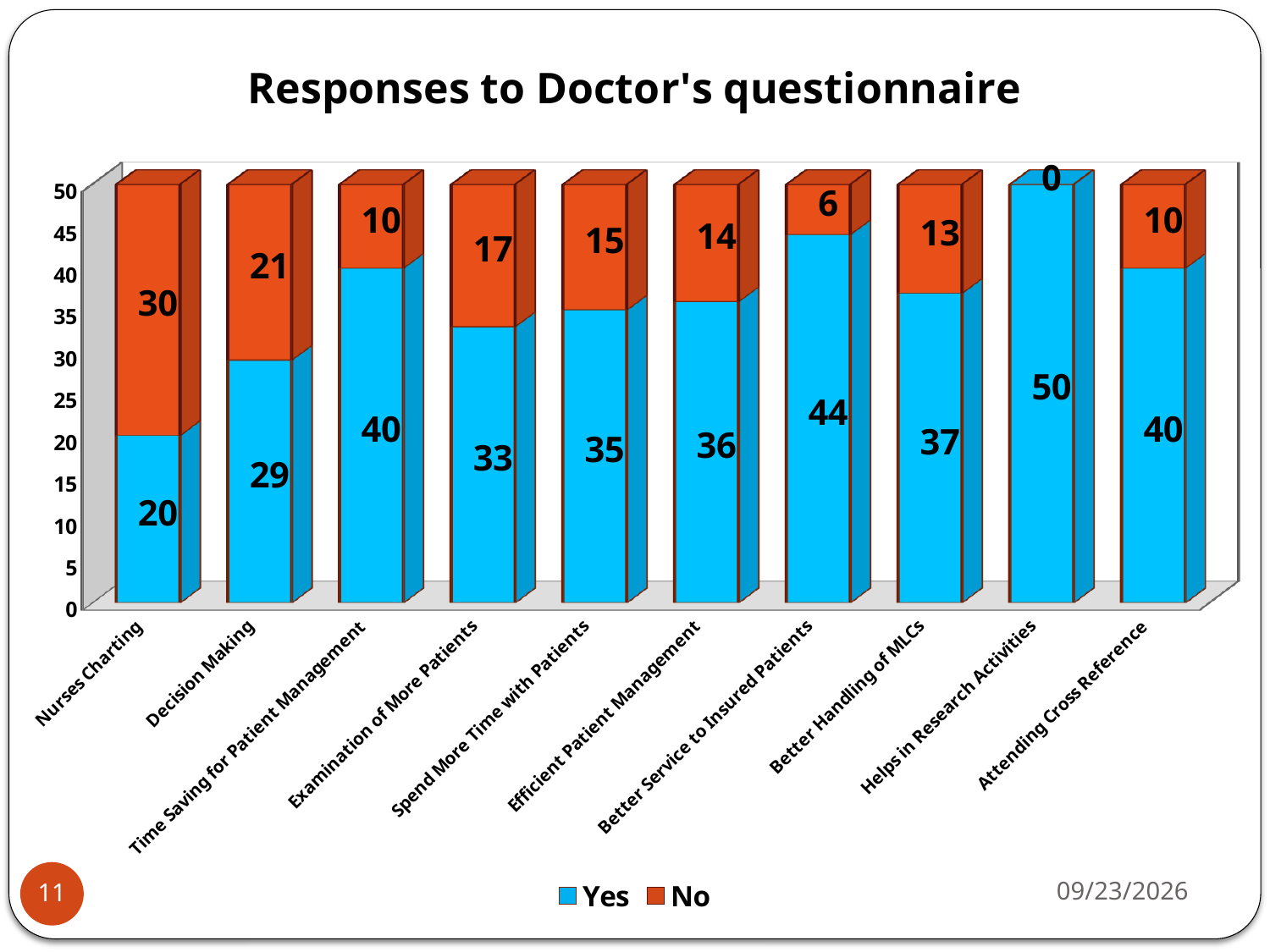
What is the Yes value for Nurses Charting? 20 Which category has the lowest Yes value? Nurses Charting What is the Yes value for Better Handling of MLCs? 37 Which is larger, the No value for Nurses Charting or the No value for Attending Cross Reference? Nurses Charting How many series does the legend list? 2 What is the total of the stacked bar for Efficient Patient Management? 50 What is the difference between the Yes values for Better Service to Insured Patients and Examination of More Patients? 11 Which category has the highest Yes value? Helps in Research Activities What is the No value for Helps in Research Activities? 0 How many categories are shown on the x axis? 10 What is the No value for Decision Making? 21 What kind of chart is shown on the slide? Stacked bar chart